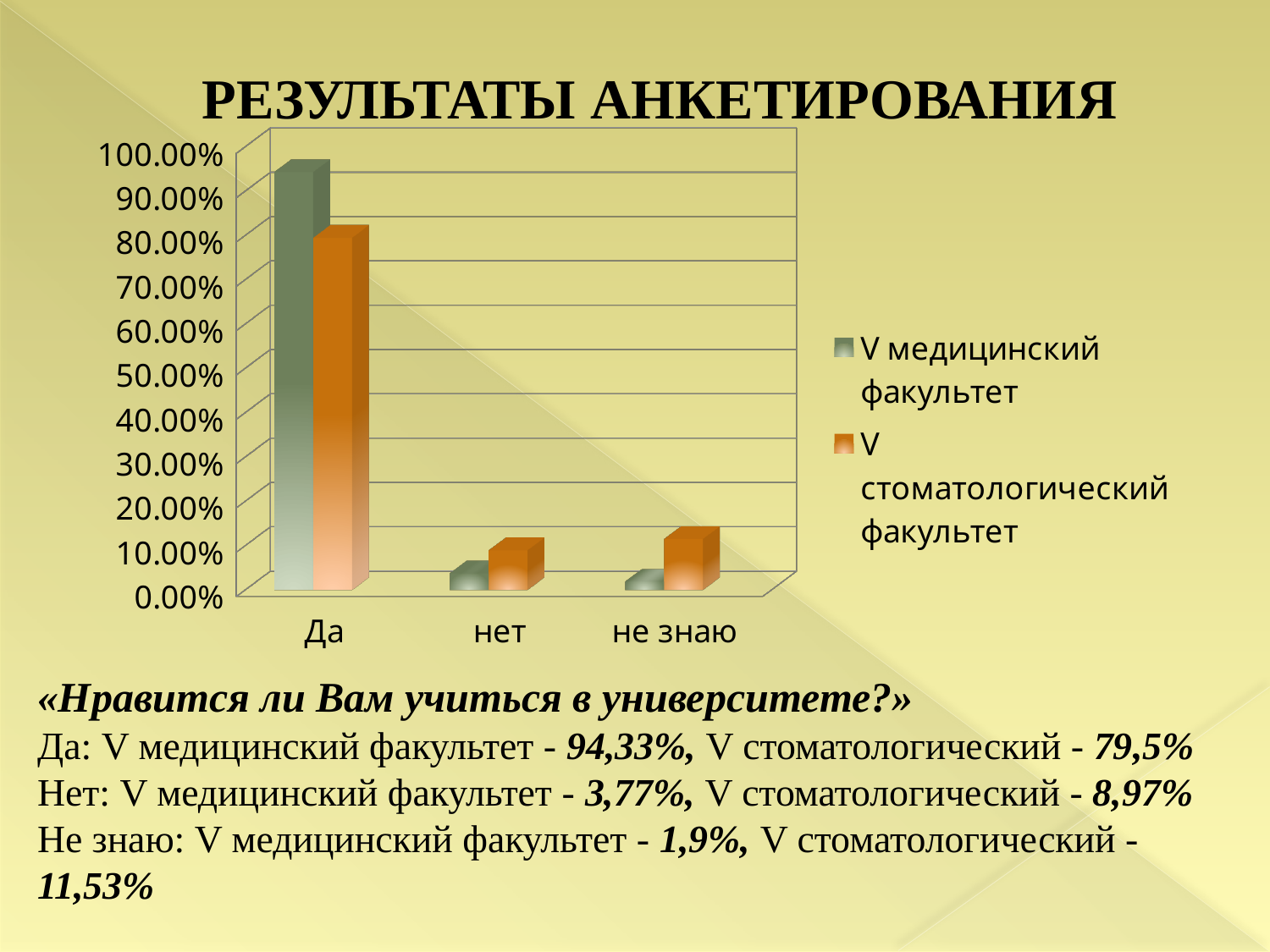
What is the value for "Да" for V стоматологический факультет? 79,5% Is the value for "Да" for V стоматологический факультет greater or less than 70.00%? greater What is the value for "не знаю" for V медицинский факультет? 1,9% What is the value for "Да" for V медицинский факультет? 94,33% How many series does the legend list? 2 For "не знаю", which series has the larger value? V стоматологический факультет What kind of chart is shown on the slide? bar chart Which category has the highest value for V медицинский факультет? Да How many categories are shown on the x axis of the chart? 3 What is the value for "нет" for V стоматологический факультет? 8,97% What is the difference between the "Да" values for V медицинский факультет and V стоматологический факультет? 14,83% Which category has the lowest value for V стоматологический факультет? нет